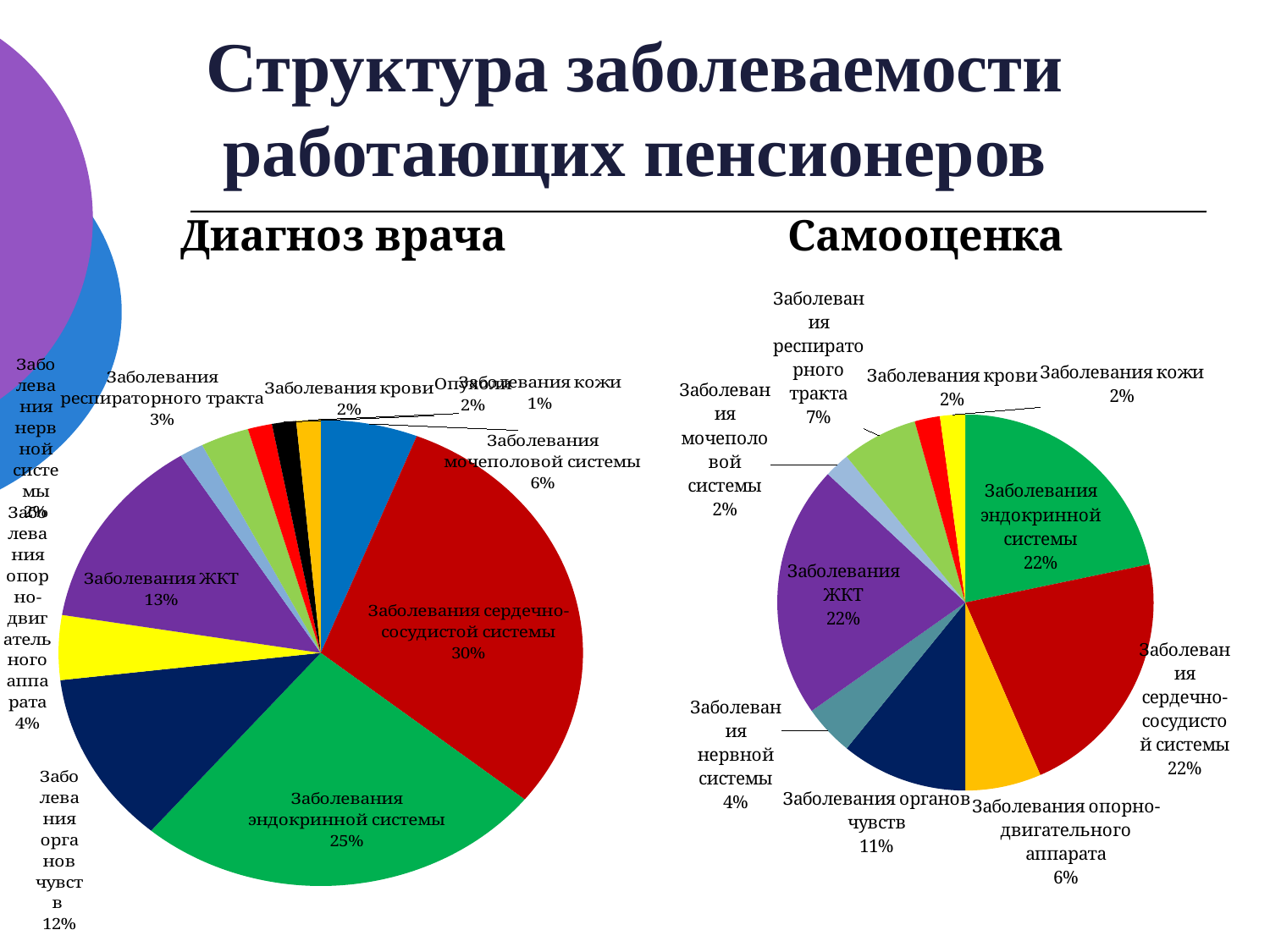
What is the difference between the share of Заболевания ЖКТ in the "Самооценка" chart and in the "Диагноз врача" chart? 9% How many categories are shown in the "Самооценка" pie chart? 10 In the "Диагноз врача" chart, what is the difference between Заболевания ЖКТ and Заболевания органов чувств? 1% In the "Диагноз врача" chart, which category has the largest share? Заболевания сердечно-сосудистой системы What kind of chart is used under "Диагноз врача"? Pie chart In the "Самооценка" chart, which is larger: Заболевания опорно-двигательного аппарата or Заболевания нервной системы? Заболевания опорно-двигательного аппарата In the "Самооценка" chart, what share is Заболевания органов чувств? 11% In the "Диагноз врача" chart, which category has the smallest share? Заболевания кожи In the "Диагноз врача" chart, what share is Заболевания сердечно-сосудистой системы? 30% In the "Самооценка" chart, what share is Заболевания респираторного тракта? 7% In the "Диагноз врача" chart, what share is Заболевания эндокринной системы? 25% What is the title of the slide? Структура заболеваемости работающих пенсионеров